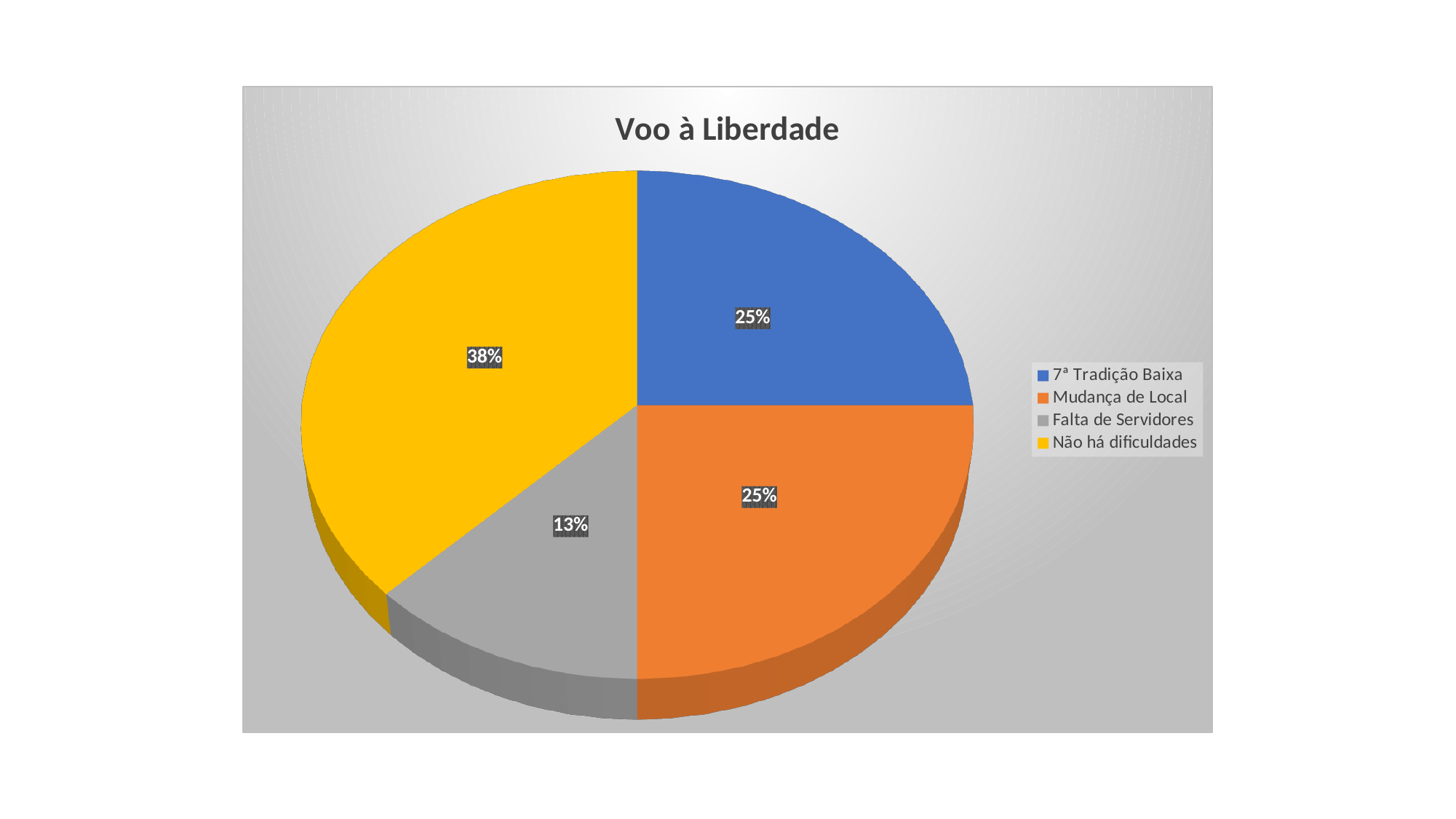
Which category has the largest slice of the pie? Não há dificuldades What is the title of the chart? Voo à Liberdade What colour is the slice for 'Não há dificuldades'? yellow What is the value shown for '7ª Tradição Baixa'? 25% What type of chart is shown on the slide? pie chart What share of the pie does 'Falta de Servidores' represent? 13% How many categories does the pie chart have? 4 What share of the pie does 'Não há dificuldades' represent? 38% Which is larger, the slice for 'Mudança de Local' or the slice for 'Falta de Servidores'? Mudança de Local What is the value shown for 'Mudança de Local'? 25% Which category has the smallest slice of the pie? Falta de Servidores What is the difference between the shares of 'Não há dificuldades' and 'Falta de Servidores'? 25%